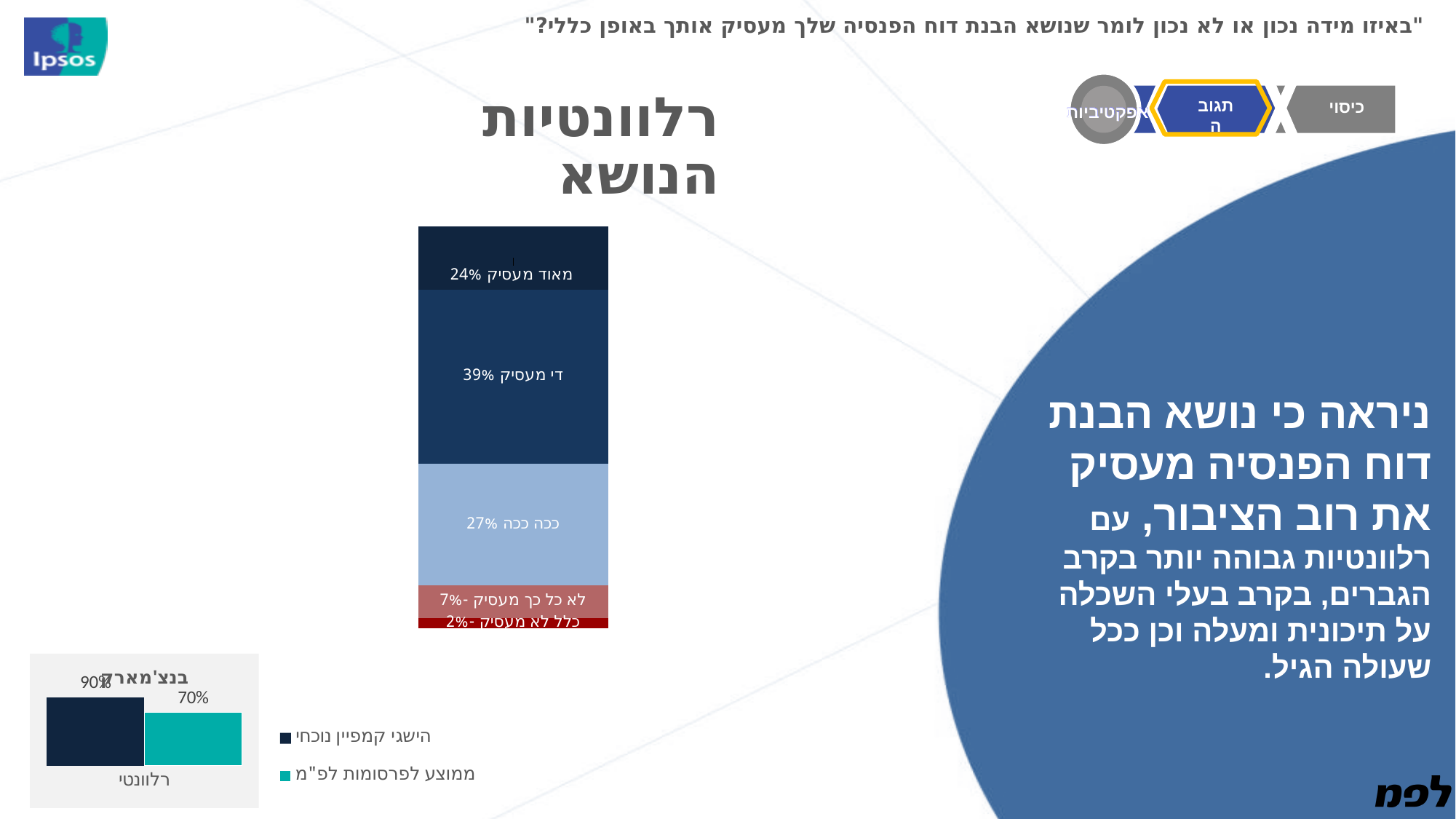
In the stacked bar chart under the heading רלוונטיות הנושא, what is the combined value of the מאוד מעסיק and די מעסיק segments? 63% In the benchmark chart (בנצ'מארק) at the bottom left, what is the value for הישגי קמפיין נוכחי? 90% In the stacked bar chart under the heading רלוונטיות הנושא, which segment has the smallest value? כלל לא מעסיק In the benchmark chart (בנצ'מארק) at the bottom left, how many series does the legend list? 2 In the stacked bar chart under the heading רלוונטיות הנושא, what is the value for the segment ככה ככה? 27% In the stacked bar chart under the heading רלוונטיות הנושא, which segment has the largest value? די מעסיק In the stacked bar chart under the heading רלוונטיות הנושא, what is the difference between the די מעסיק segment and the מאוד מעסיק segment? 15% In the stacked bar chart under the heading רלוונטיות הנושא, what is the value for the segment כלל לא מעסיק? 2% In the stacked bar chart under the heading רלוונטיות הנושא, what is the value for the segment מאוד מעסיק? 24% In the stacked bar chart under the heading רלוונטיות הנושא, what is the value for the segment די מעסיק? 39% In the stacked bar chart under the heading רלוונטיות הנושא, how many segments make up the bar? 5 In the benchmark chart (בנצ'מארק) at the bottom left, what is the value for ממוצע לפרסומות לפ"מ? 70%